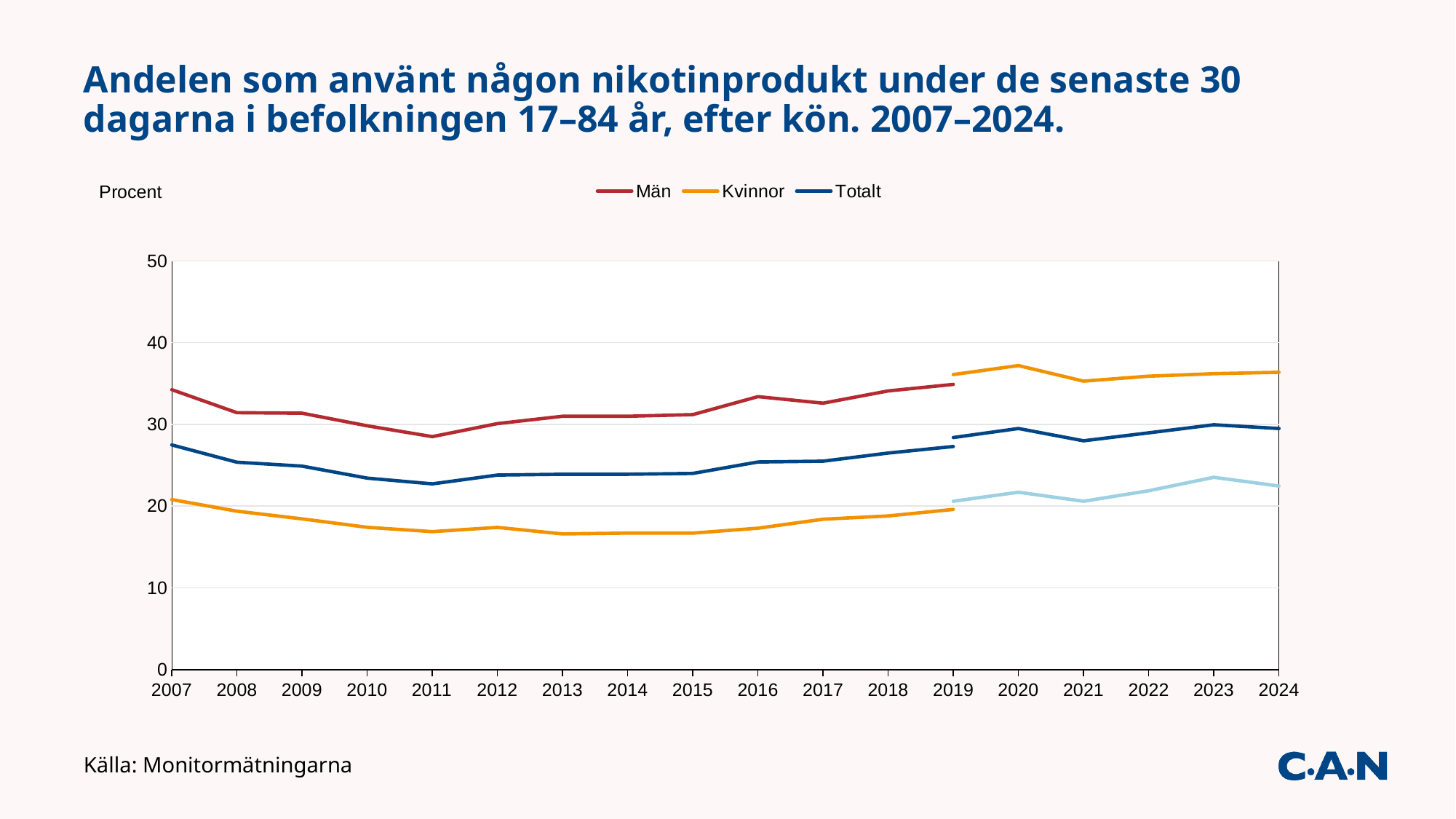
Is the value for Totalt in 2011 greater or less than 20? greater Is the value for Män in 2007 greater or less than 30? greater Which series has the highest value in 2007? Män How many series does the legend list? 3 What is the label shown on the y axis? Procent In 2015, which is larger, the value for Män or the value for Kvinnor? Män Is the value for Kvinnor in 2011 greater or less than 20? less Does the Kvinnor line rise or fall between 2007 and 2011? fall Which series has the lowest value in 2018? Kvinnor What kind of chart is shown on the slide? line chart How many years are shown along the x axis? 18